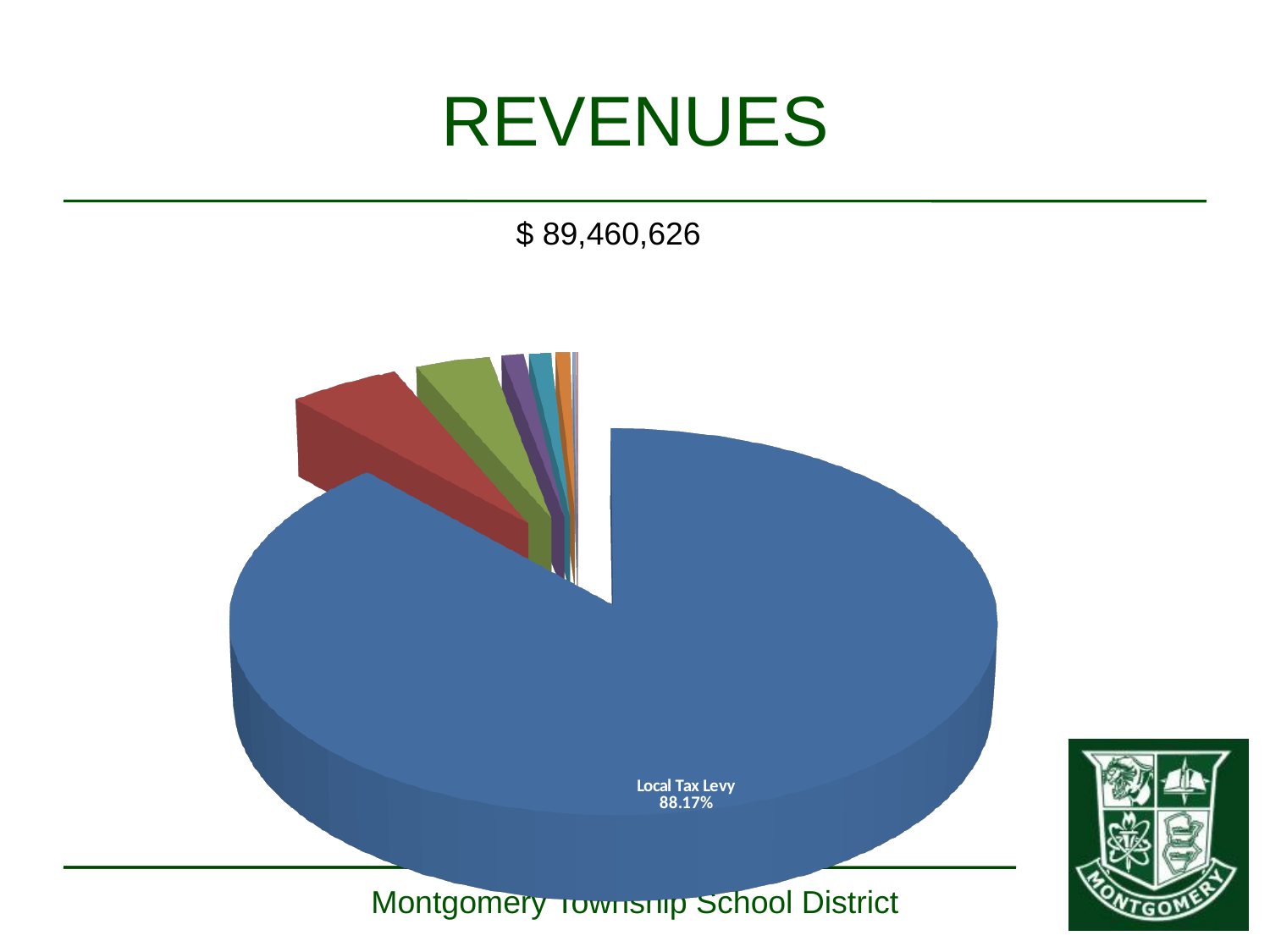
What is the title of the slide containing the pie chart? REVENUES Which is larger, the red slice or the green slice? the red slice What total revenue amount is printed above the pie chart? $ 89,460,626 What kind of chart is shown on the slide? pie chart Which slice of the pie chart is the largest? Local Tax Levy Which is larger, the Local Tax Levy slice or the red slice? Local Tax Levy What share of revenues does the Local Tax Levy slice represent? 88.17%